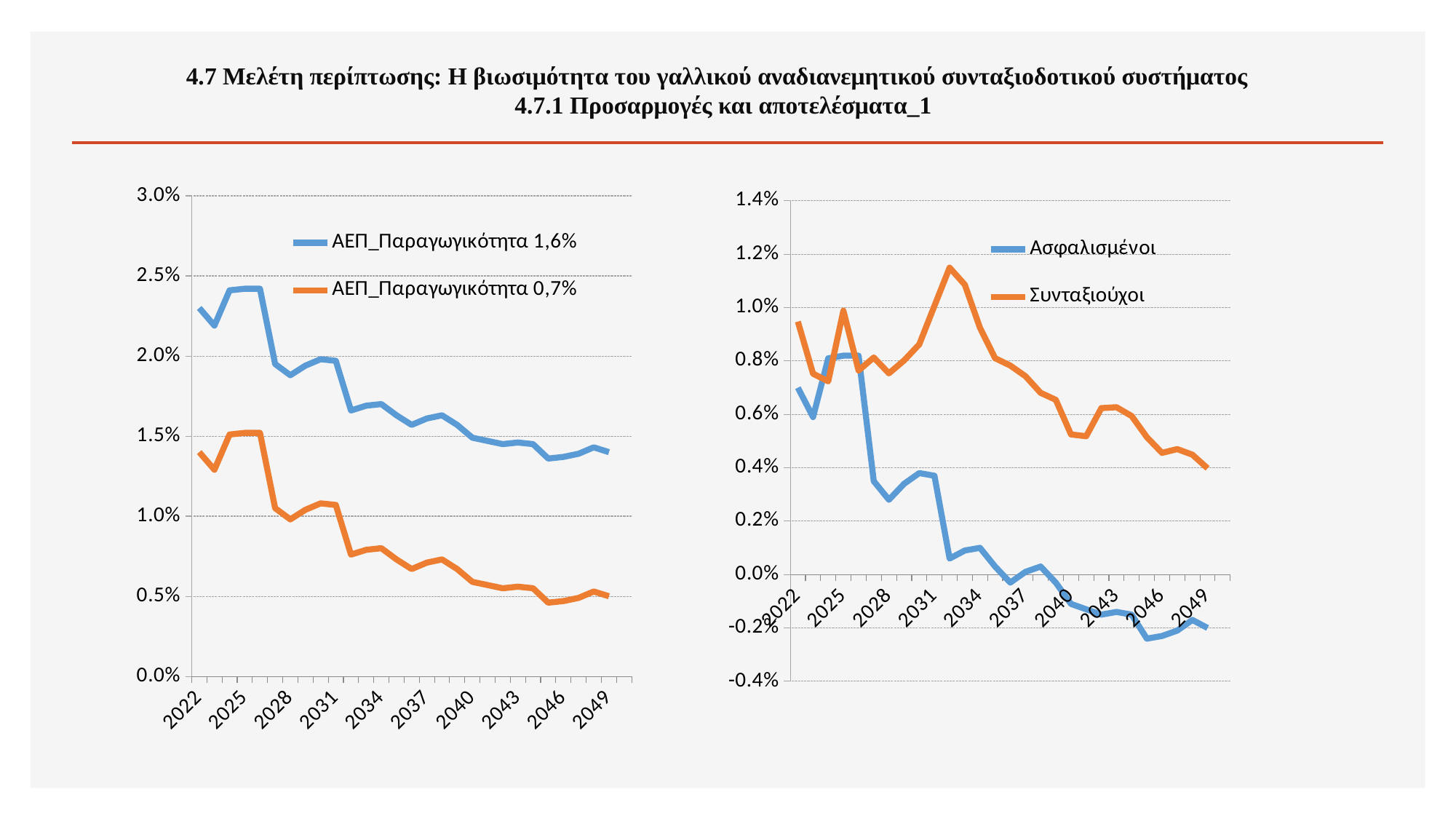
In the right chart, which series has the higher value in 2040? Συνταξιούχοι What kind of chart is the right chart on the slide? Line chart What kind of chart is the left chart on the slide? Line chart In the left chart, is the value of ΑΕΠ_Παραγωγικότητα 0,7% in 2049 greater or less than 1.0%? less How many series does the legend of the left chart list? 2 In the right chart, is the value of Ασφαλισμένοι in 2046 greater or less than 0.0%? less In the right chart, which series is shown in blue? Ασφαλισμένοι In the right chart, does the Ασφαλισμένοι series overall rise or fall from 2022 to 2049? fall In the left chart, which series has the higher value in 2040? ΑΕΠ_Παραγωγικότητα 1,6% How many series does the legend of the right chart list? 2 In the left chart, which series is shown in orange? ΑΕΠ_Παραγωγικότητα 0,7% In the left chart, is the value of ΑΕΠ_Παραγωγικότητα 1,6% in 2022 greater or less than 2.0%? greater